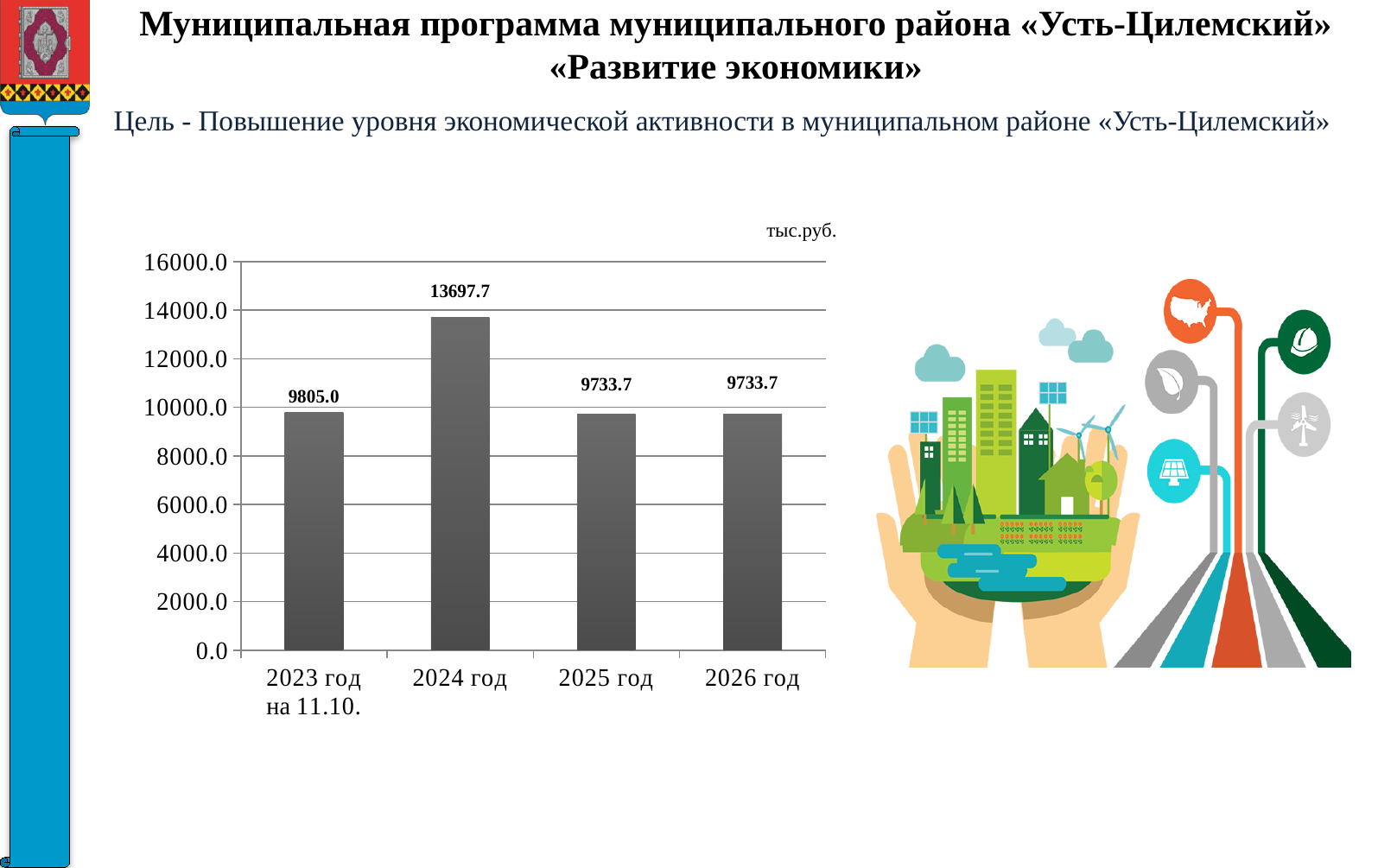
What unit is indicated above the chart? тыс.руб. Which is larger, the value for 2023 год на 11.10. or the value for 2025 год? 2023 год на 11.10. What kind of chart is shown on the slide? bar chart Is the value for 2024 год greater or less than 12000.0? greater What is the difference between the values for 2024 год and 2023 год на 11.10.? 3892.7 What is the value for 2023 год на 11.10.? 9805.0 What is the difference between the values for 2023 год на 11.10. and 2025 год? 71.3 How many bars are shown in the chart? 4 What is the value for 2026 год? 9733.7 Is the value for 2025 год greater or less than 10000.0? less Which year has the highest value? 2024 год What is the value for 2024 год? 13697.7